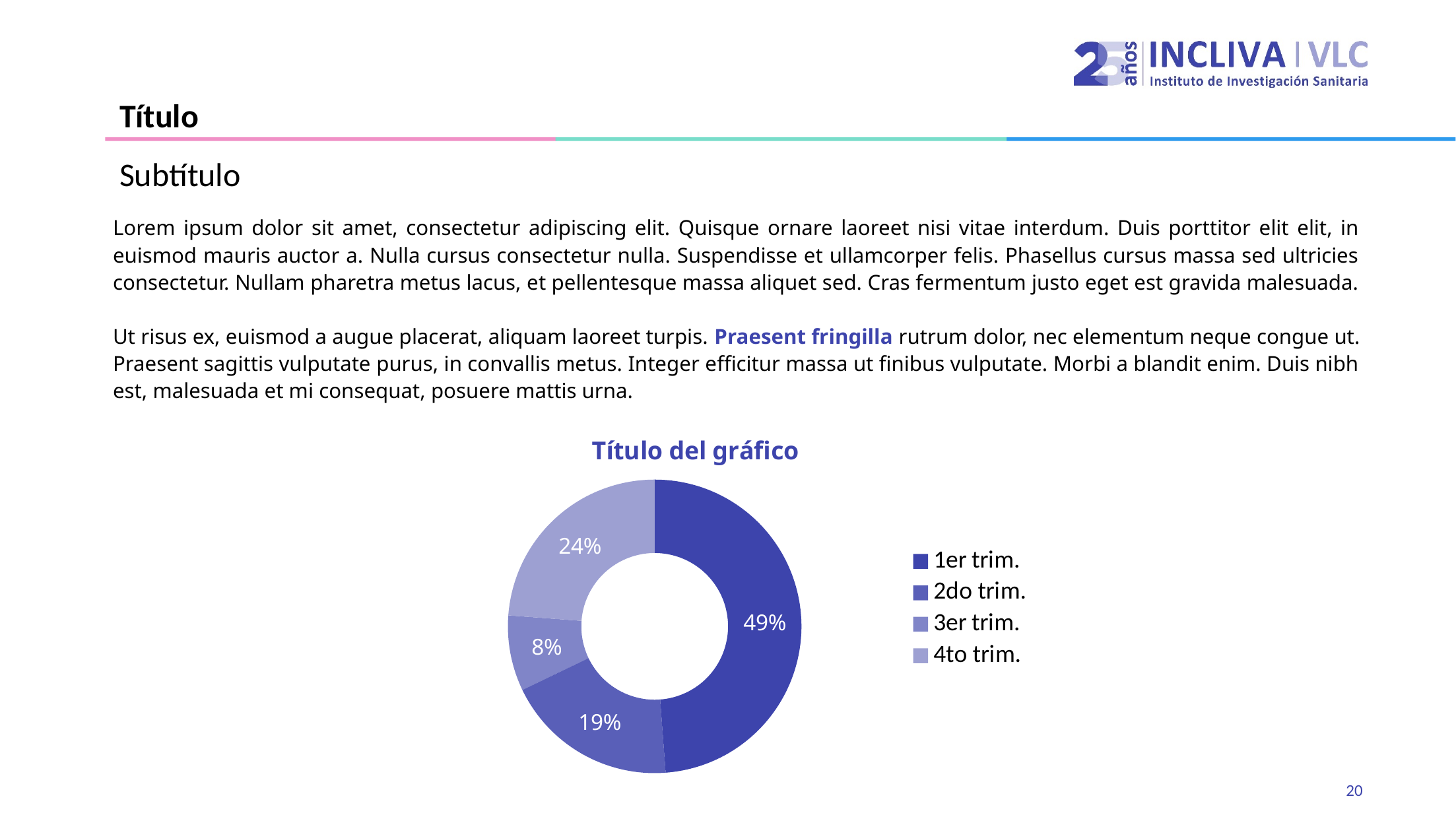
What kind of chart is shown on the slide? Doughnut chart Which slice has the smallest share of the chart? 3er trim. What percentage does the 4to trim. slice show? 24% What is the difference in percentage points between the 1er trim. and 4to trim. slices? 25 Which is larger, the 2do trim. slice or the 4to trim. slice? 4to trim. How many series does the legend list? 4 What percentage does the 2do trim. slice show? 19% What is the title of the chart? Título del gráfico How many slices does the chart have? 4 What percentage does the 1er trim. slice show? 49% What percentage does the 3er trim. slice show? 8% Which slice has the largest share of the chart? 1er trim.